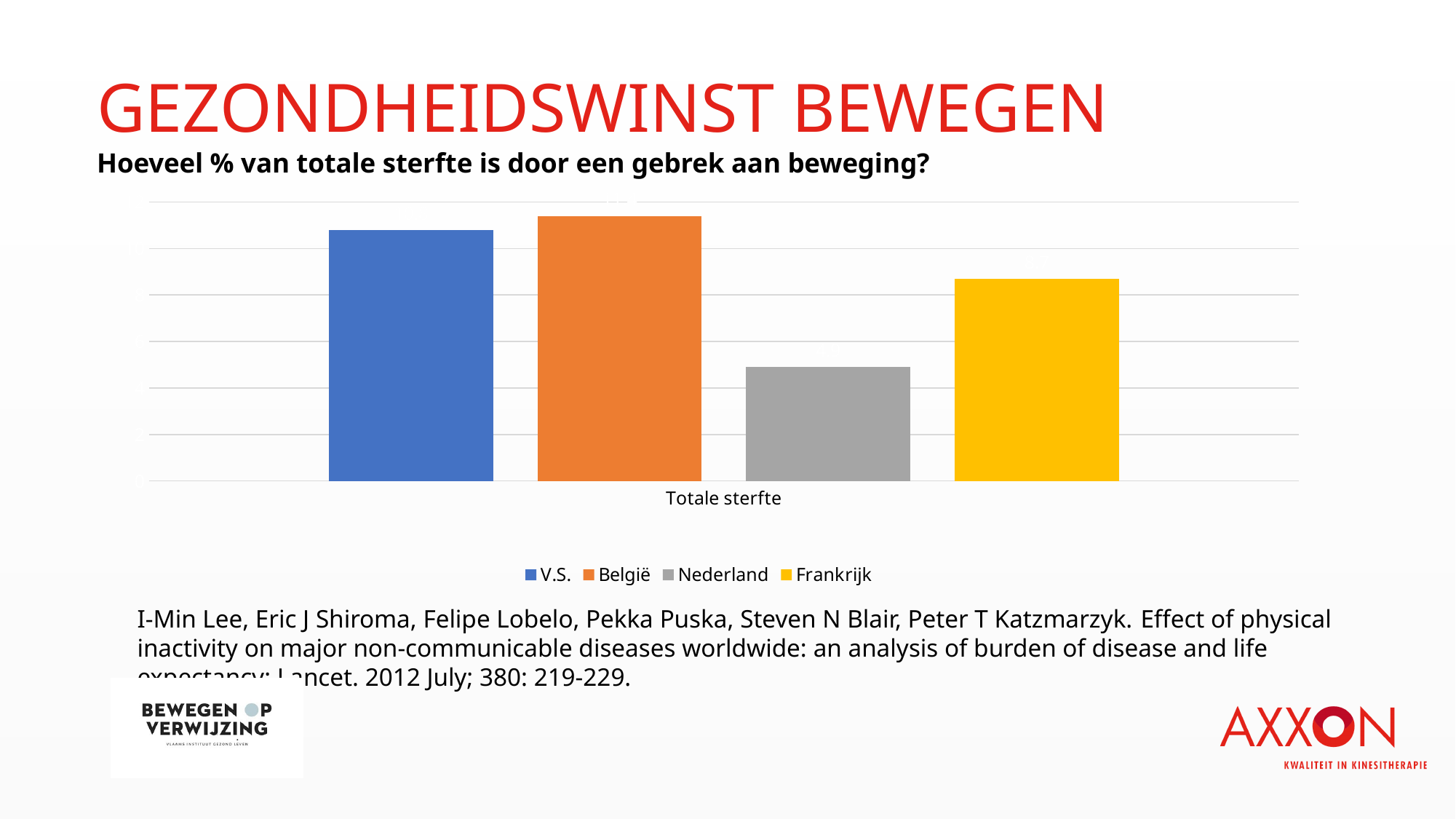
Which country has the lowest bar in the chart? Nederland Which colour represents Frankrijk in the chart? yellow What kind of chart is shown on the slide? bar chart Which is larger, the value for Nederland or the value for Frankrijk? Frankrijk How many categories are shown on the x axis? 1 Which country has the highest bar in the chart? België How many series does the legend list? 4 What is the label of the category on the x axis? Totale sterfte Which is larger, the value for V.S. or the value for Frankrijk? V.S. Which is larger, the value for V.S. or the value for Nederland? V.S.